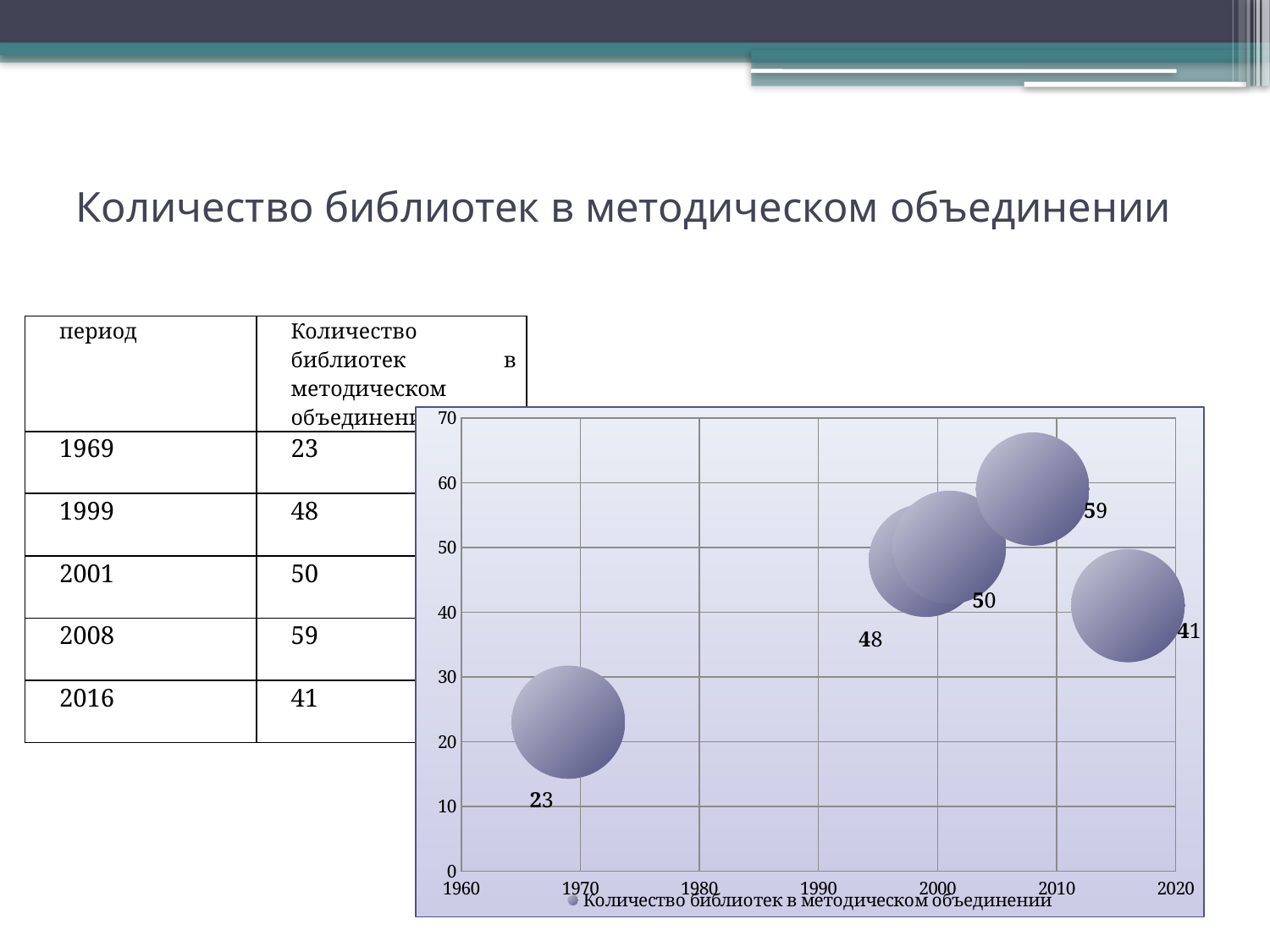
What type of chart is shown on the slide? Bubble chart How many series does the chart legend list? 1 What is the legend entry shown below the chart? Количество библиотек в методическом объединении Which is larger in the chart: the value for 1999 or the value for 2001? 2001 Which year has the lowest value in the chart? 1969 What is the difference between the values for 2008 and 2016 in the chart? 18 Which year has the highest value in the chart? 2008 What is the value of the data point for 2016 in the chart? 41 What is the value of the data point labelled for 1969 in the chart? 23 Is the value for 1969 in the chart greater or less than 30? less How many data points (bubbles) are plotted in the chart? 5 What is the value of the data point for 2008 in the chart? 59